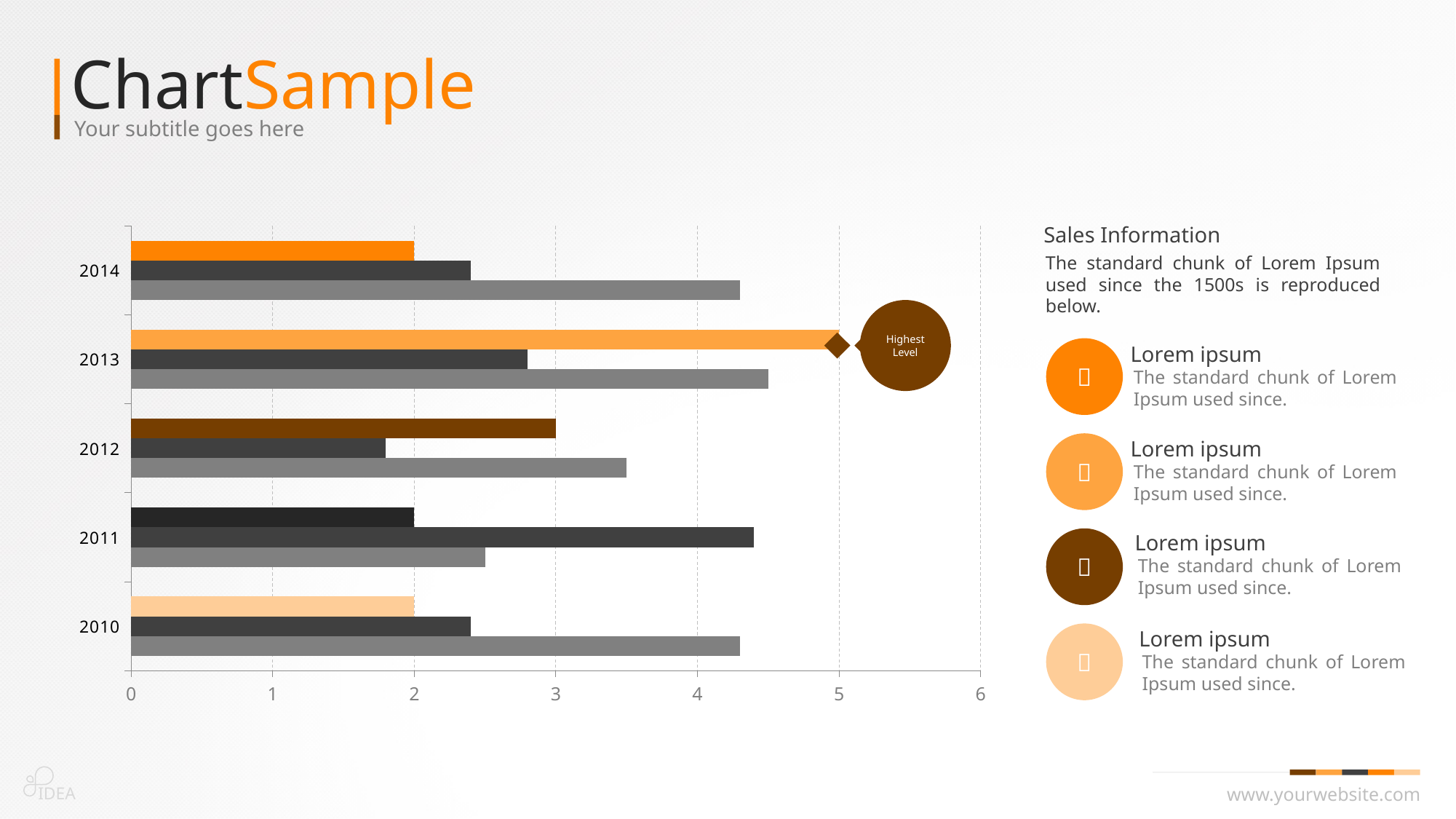
What text is written in the circular callout attached to the 2013 bar? Highest Level Is the value of the middle (dark gray) bar for 2012 greater or less than 2? less Is the value of the bottom (gray) bar for 2014 greater or less than 4? greater How many years are shown on the vertical axis of the chart? 5 Which is larger: the top bar for 2013 or the top bar for 2012? the top bar for 2013 How many bars are plotted for each year in the chart? 3 What is the value of the top (orange) bar for 2014? 2 What is the difference between the top bar for 2013 and the top bar for 2012? 2 What is the value of the top (brown) bar for 2012? 3 What is the value of the top (light orange) bar for 2013? 5 What kind of chart is shown on the slide? bar chart Which year contains the longest bar in the chart? 2013